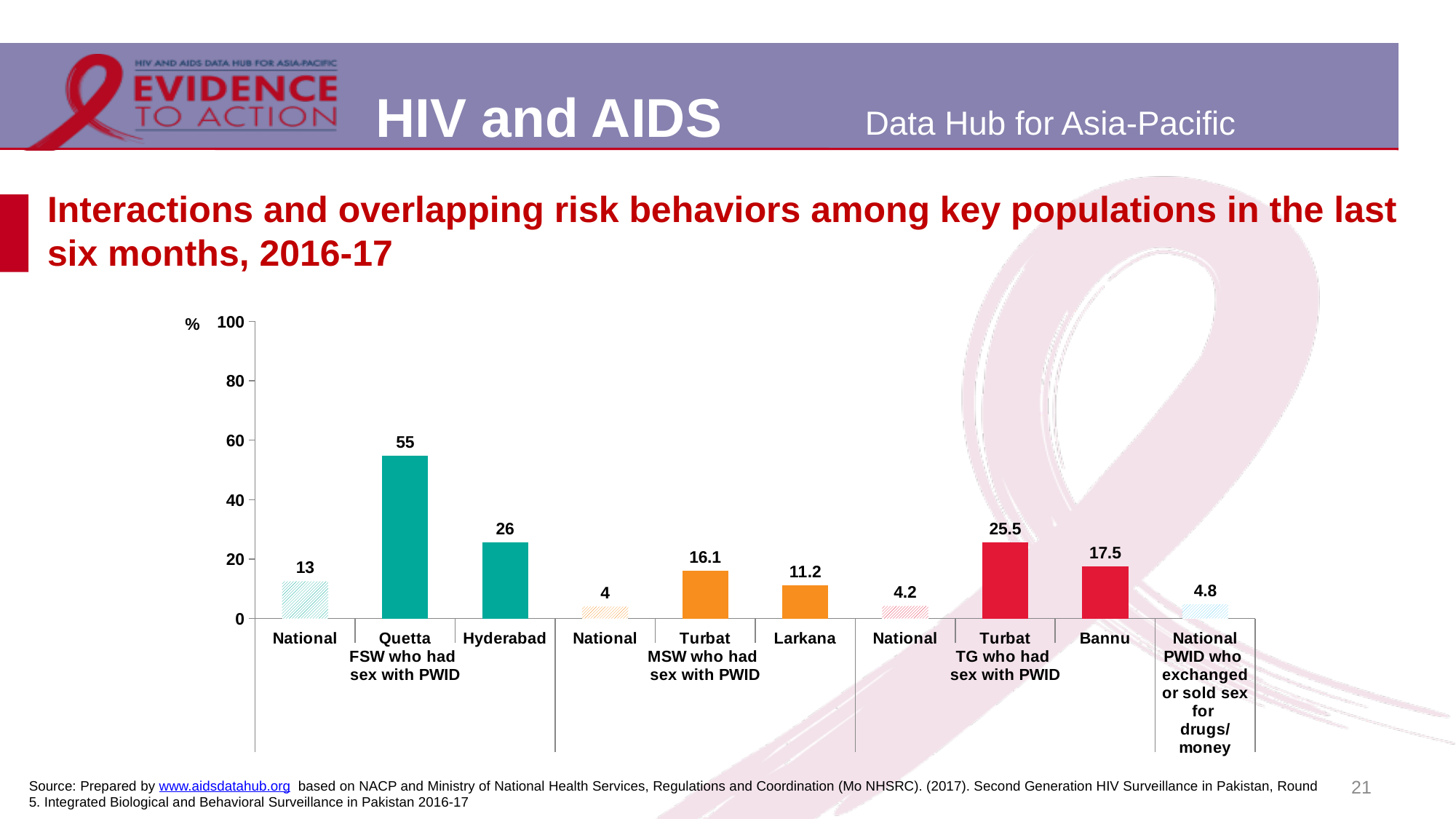
What unit is shown on the y axis of the chart? % Which bar has the lowest value on the chart? National (MSW who had sex with PWID) What is the national value for PWID who exchanged or sold sex for drugs/money? 4.8 What is the value for Bannu in the TG who had sex with PWID group? 17.5 What is the difference between the Turbat and Bannu values in the TG who had sex with PWID group? 8 What kind of chart is shown on the slide? Bar chart What is the difference between the Quetta and Hyderabad values in the FSW who had sex with PWID group? 29 Which bar has the highest value on the chart? Quetta (FSW who had sex with PWID) What is the value for Quetta in the FSW who had sex with PWID group? 55 How many bars are plotted on the chart? 10 Which is larger: the Turbat value for MSW who had sex with PWID or the Turbat value for TG who had sex with PWID? Turbat for TG who had sex with PWID What is the value for Larkana in the MSW who had sex with PWID group? 11.2